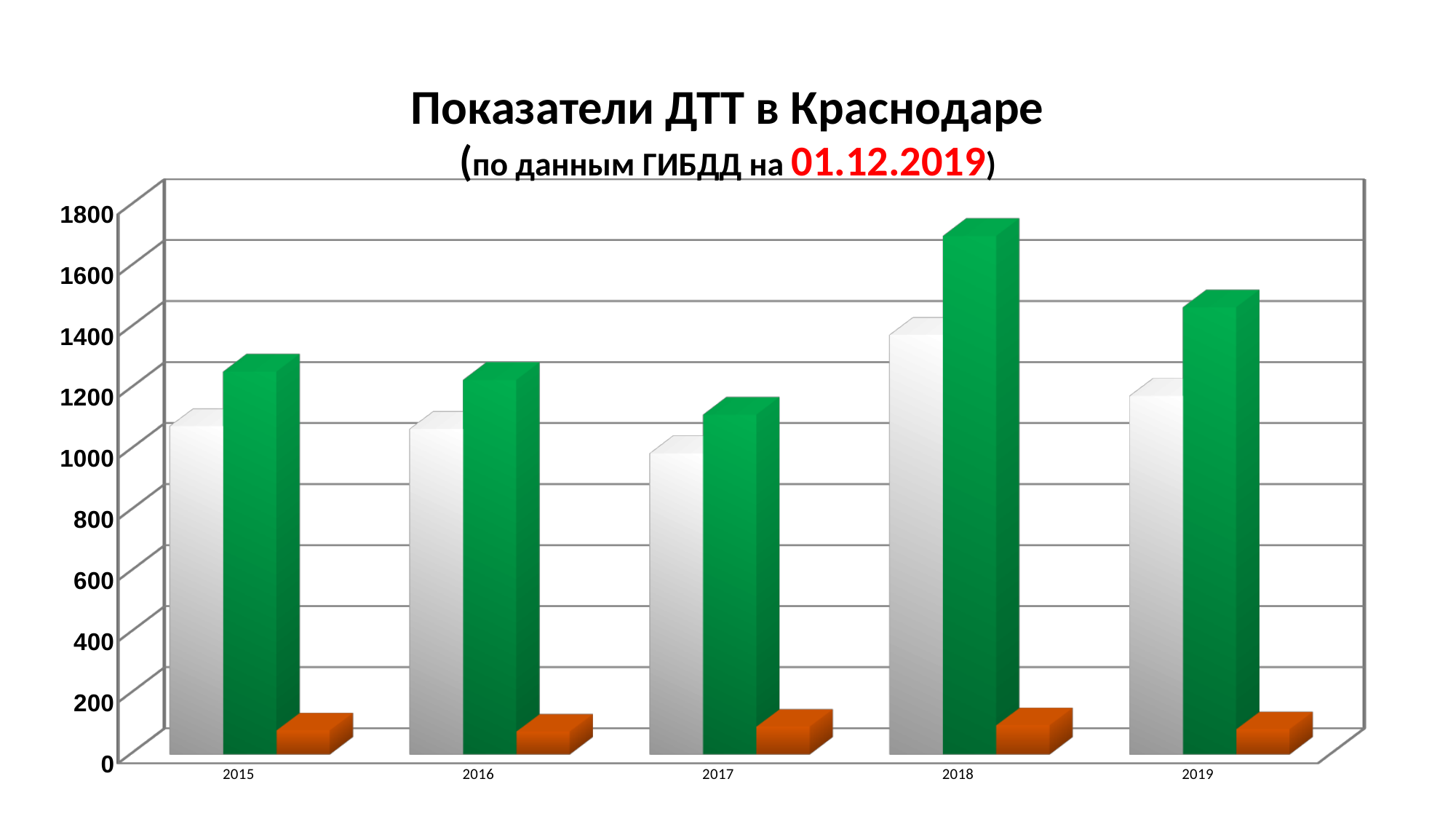
Is the value of the orange bar for 2015 greater or less than 200? less How many bars are plotted for each year in the chart? 3 What is the title of the chart? Показатели ДТТ в Краснодаре (по данным ГИБДД на 01.12.2019) What kind of chart is shown on the slide? bar chart Which is larger: the white bar for 2018 or the white bar for 2019? 2018 Is the value of the green bar for 2018 greater or less than 1600? greater How many years are shown on the x axis of the chart? 5 Is the value of the white bar for 2017 greater or less than 1200? less In which year is the white bar the shortest? 2017 In which year is the green bar the shortest? 2017 In which year is the white bar the tallest? 2018 In which year is the green bar the tallest? 2018